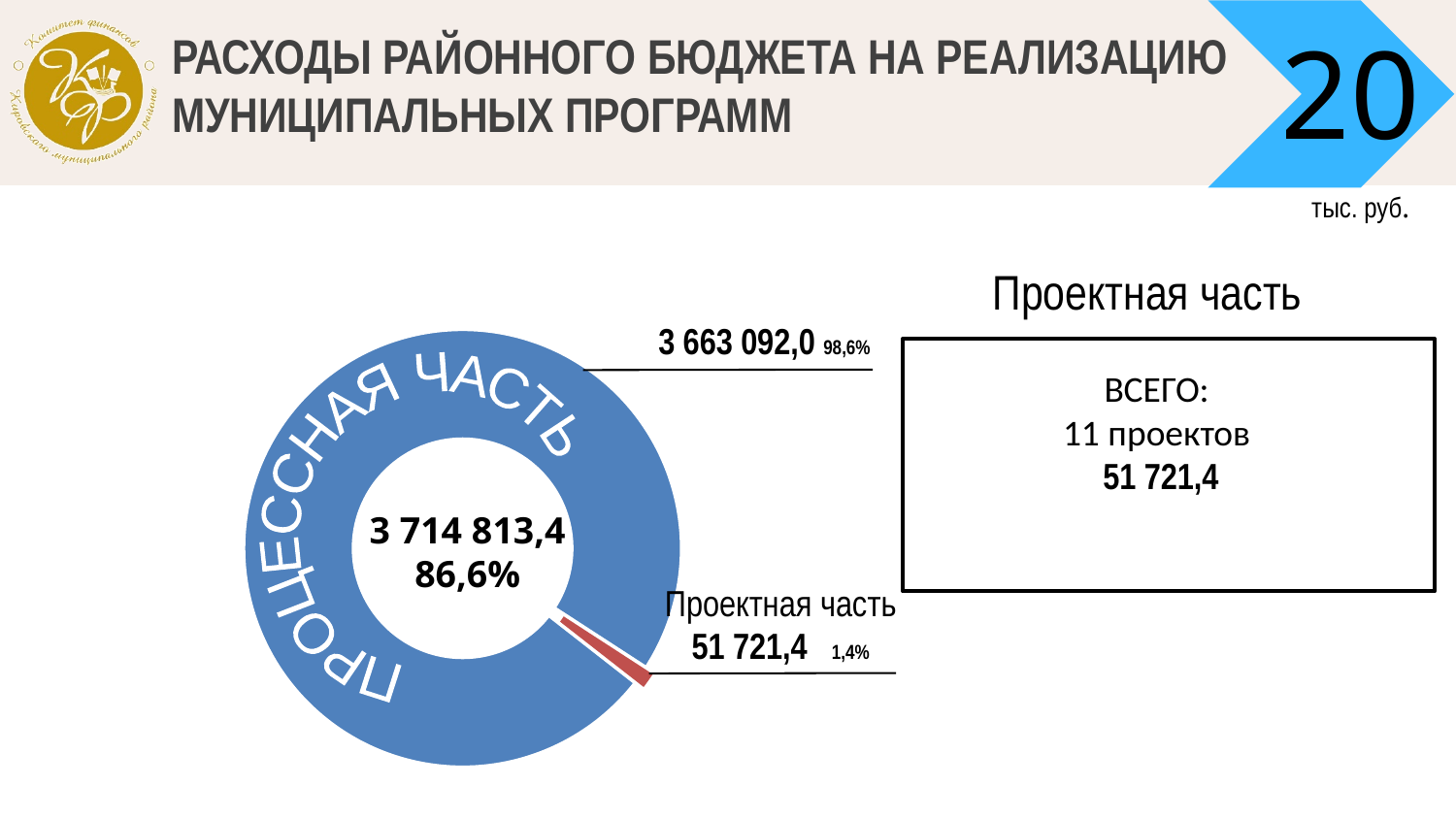
Which is larger in the chart, Процессная часть or Проектная часть? Процессная часть What kind of chart is shown on the slide? Pie (donut) chart What is the total of the two slices shown in the donut chart? 3 714 813,4 What is the value for Процессная часть in the donut chart? 3 663 092,0 What share of the donut chart does Процессная часть represent? 98,6% In what units are the values on the slide expressed? тыс. руб. Which slice of the donut chart is the largest? Процессная часть What share of the donut chart does Проектная часть represent? 1,4% How many slices does the donut chart have? 2 What is the difference between the values for Процессная часть and Проектная часть? 3 611 370,6 Which slice of the donut chart is the smallest? Проектная часть What is the value for Проектная часть in the donut chart? 51 721,4